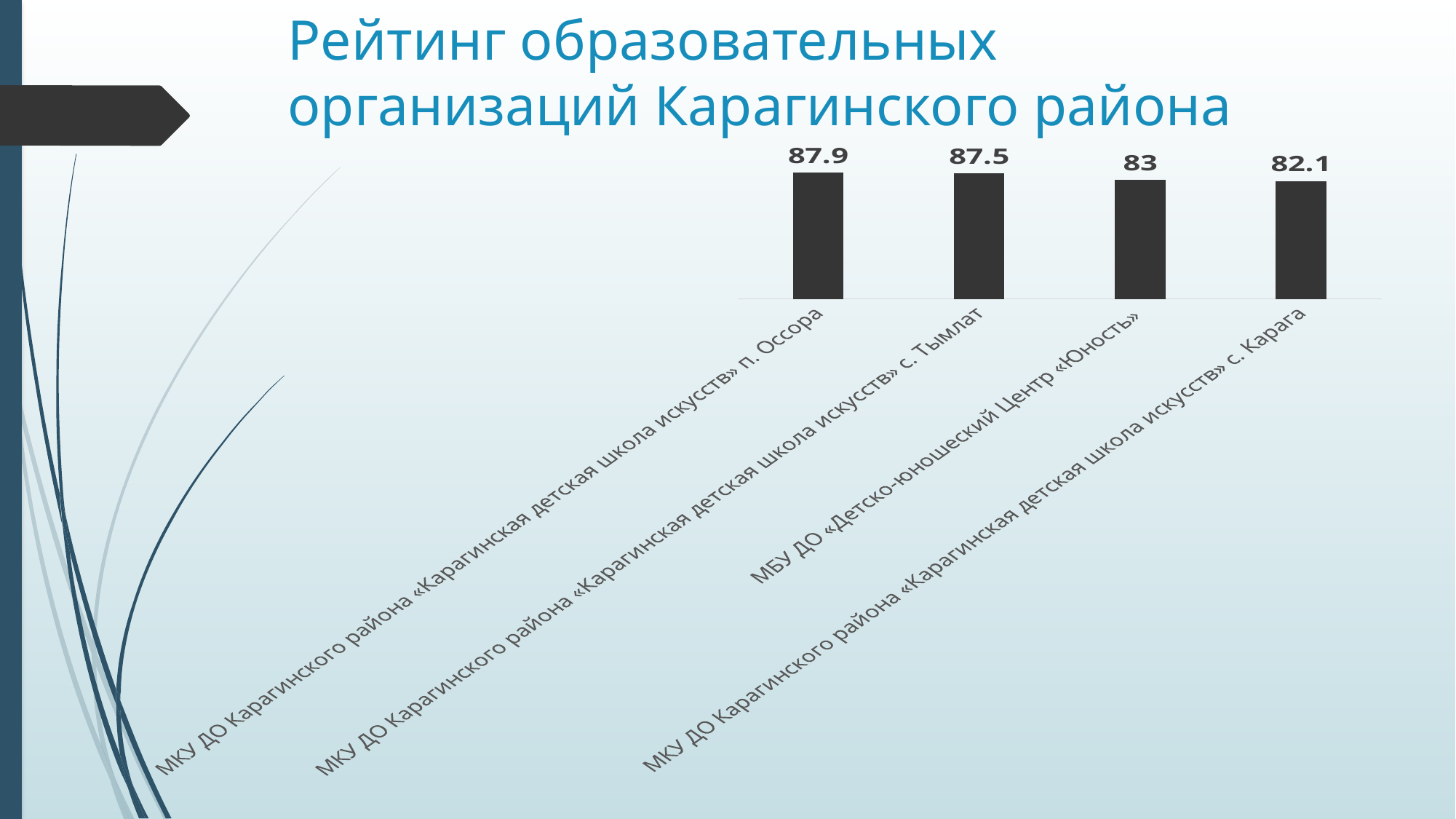
What kind of chart is shown on the slide? Bar chart Which organisation has the highest value in the chart? МКУ ДО Карагинского района «Карагинская детская школа искусств» п. Оссора What is the value for МБУ ДО «Детско-юношеский Центр «Юность»? 83 What is the difference between the values for п. Оссора and с. Карага? 5.8 Which has a larger value: МБУ ДО «Детско-юношеский Центр «Юность» or the school of arts in с. Карага? МБУ ДО «Детско-юношеский Центр «Юность» Which organisation has the lowest value in the chart? МКУ ДО Карагинского района «Карагинская детская школа искусств» с. Карага What is the value for МКУ ДО Карагинского района «Карагинская детская школа искусств» п. Оссора? 87.9 What is the difference between the values for с. Тымлат and МБУ ДО «Детско-юношеский Центр «Юность»? 4.5 Do the values rise or fall from left to right across the chart? Fall How many organisations are shown in the chart? 4 What is the value for МКУ ДО Карагинского района «Карагинская детская школа искусств» с. Тымлат? 87.5 What is the value for МКУ ДО Карагинского района «Карагинская детская школа искусств» с. Карага? 82.1